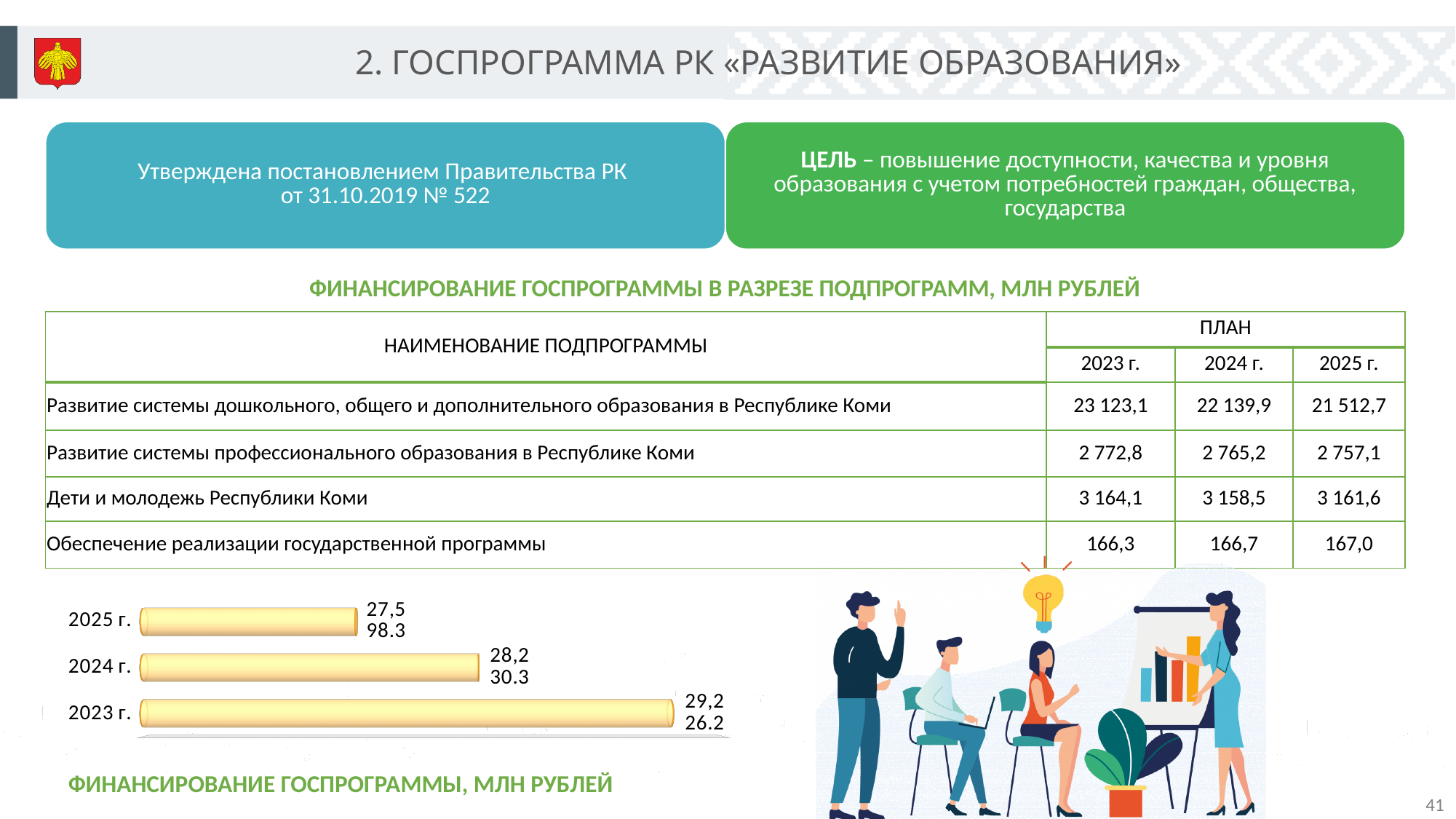
What is the title of the bar chart? ФИНАНСИРОВАНИЕ ГОСПРОГРАММЫ, МЛН РУБЛЕЙ Which year has the shortest bar in the bar chart? 2025 г. How many categories (years) does the bar chart show? 3 What kind of chart is shown at the bottom left of the slide? bar chart Which year is listed at the top of the bar chart? 2025 г. Do the bar lengths in the chart increase or decrease from 2023 г. to 2025 г.? decrease What colour are the bars in the bar chart? yellow In the bar chart, is the bar for 2024 г. longer or shorter than the bar for 2023 г.? shorter In the bar chart, which bar is longer: 2024 г. or 2025 г.? 2024 г. Which year has the longest bar in the bar chart? 2023 г.